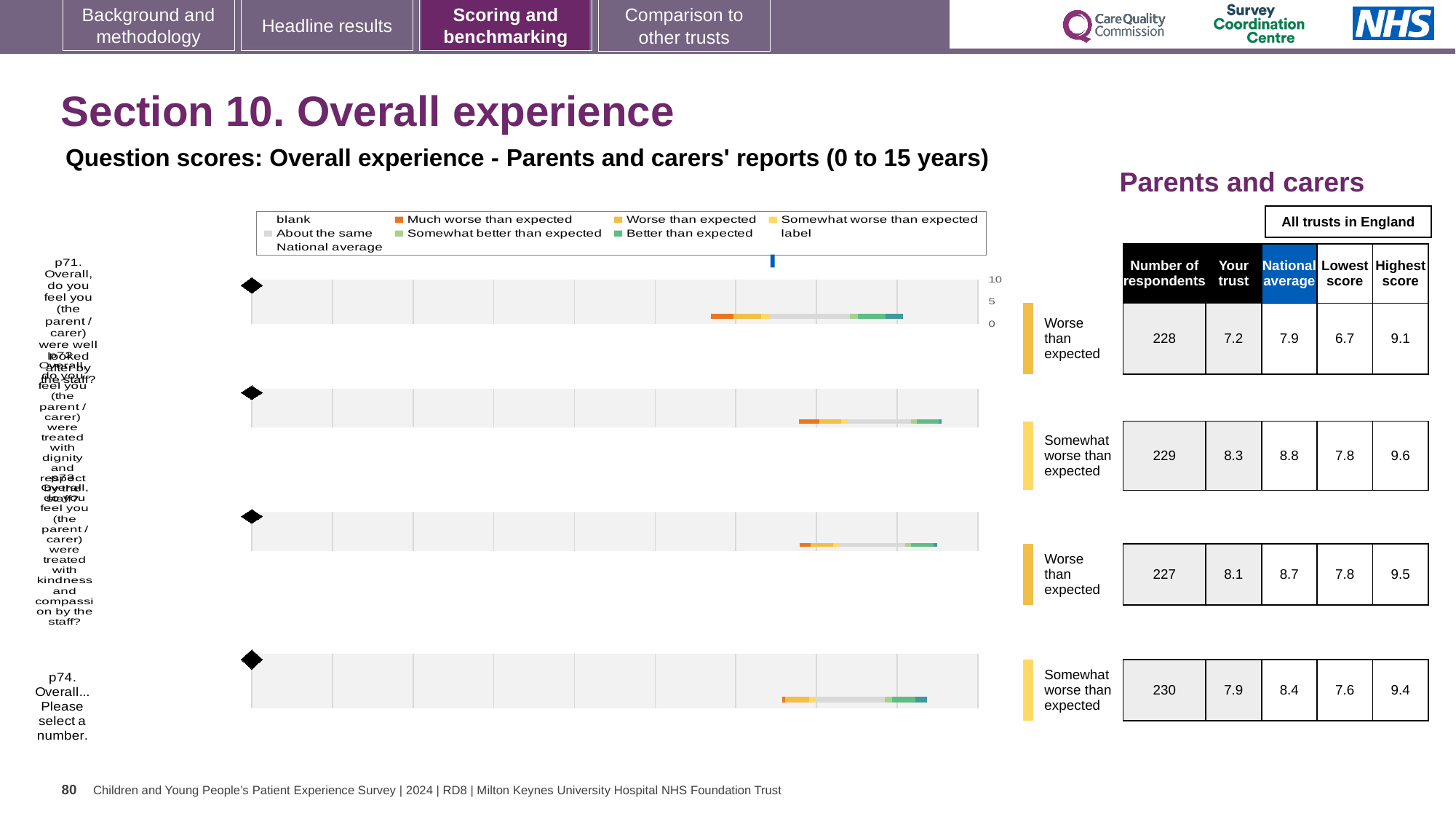
What benchmark category is shown for the first question row (p71)? Worse than expected For p74, which is larger: the 'Your trust' score or the national average? National average How many respondents are listed for the first question row (p71)? 228 Which question row has the highest 'Your trust' score? p72 (8.3) What is the 'Your trust' score for p74 (Overall... Please select a number)? 7.9 How many questions (rows) are plotted in the question scores chart? 4 What is the highest score across all trusts in England for p74? 9.4 Is the 'Your trust' score for p74 greater or less than 5? greater What kind of chart is used to show the question scores on this slide? bar chart Which question row has the lowest 'Your trust' score? p71 (7.2) For the first question row (p71), what is the difference between the national average and the 'Your trust' score? 0.7 What is the national average score for p74 (Overall... Please select a number)? 8.4